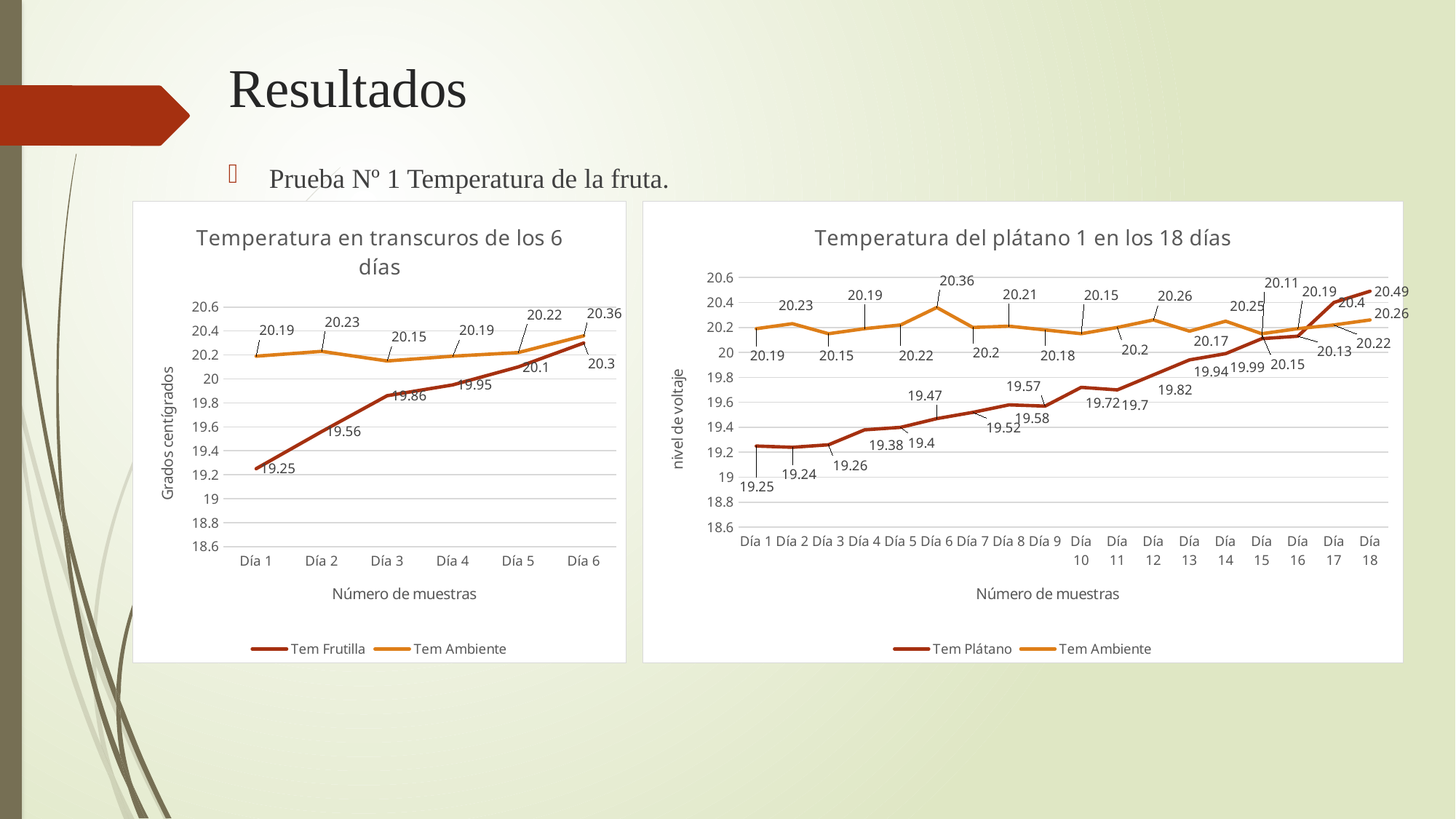
In the left chart 'Temperatura en transcuros de los 6 días', on which day is Tem Frutilla lowest? Día 1 In the left chart 'Temperatura en transcuros de los 6 días', what is the Tem Frutilla value on Día 3? 19.86 In the left chart 'Temperatura en transcuros de los 6 días', does Tem Frutilla rise or fall from Día 1 to Día 6? rise In the right chart 'Temperatura del plátano 1 en los 18 días', which is larger on Día 17, Tem Plátano or Tem Ambiente? Tem Plátano In the left chart 'Temperatura en transcuros de los 6 días', what is the Tem Ambiente value on Día 6? 20.36 In the left chart 'Temperatura en transcuros de los 6 días', how many series does the legend list? 2 In the right chart 'Temperatura del plátano 1 en los 18 días', how many days are shown on the x axis? 18 In the right chart 'Temperatura del plátano 1 en los 18 días', what is the Tem Plátano value on Día 18? 20.49 In the right chart 'Temperatura del plátano 1 en los 18 días', on which day is Tem Plátano highest? Día 18 What kind of chart is the right chart 'Temperatura del plátano 1 en los 18 días'? line chart In the left chart 'Temperatura en transcuros de los 6 días', what is the difference between Tem Ambiente and Tem Frutilla on Día 1? 0.94 In the right chart 'Temperatura del plátano 1 en los 18 días', what is the Tem Ambiente value on Día 6? 20.36